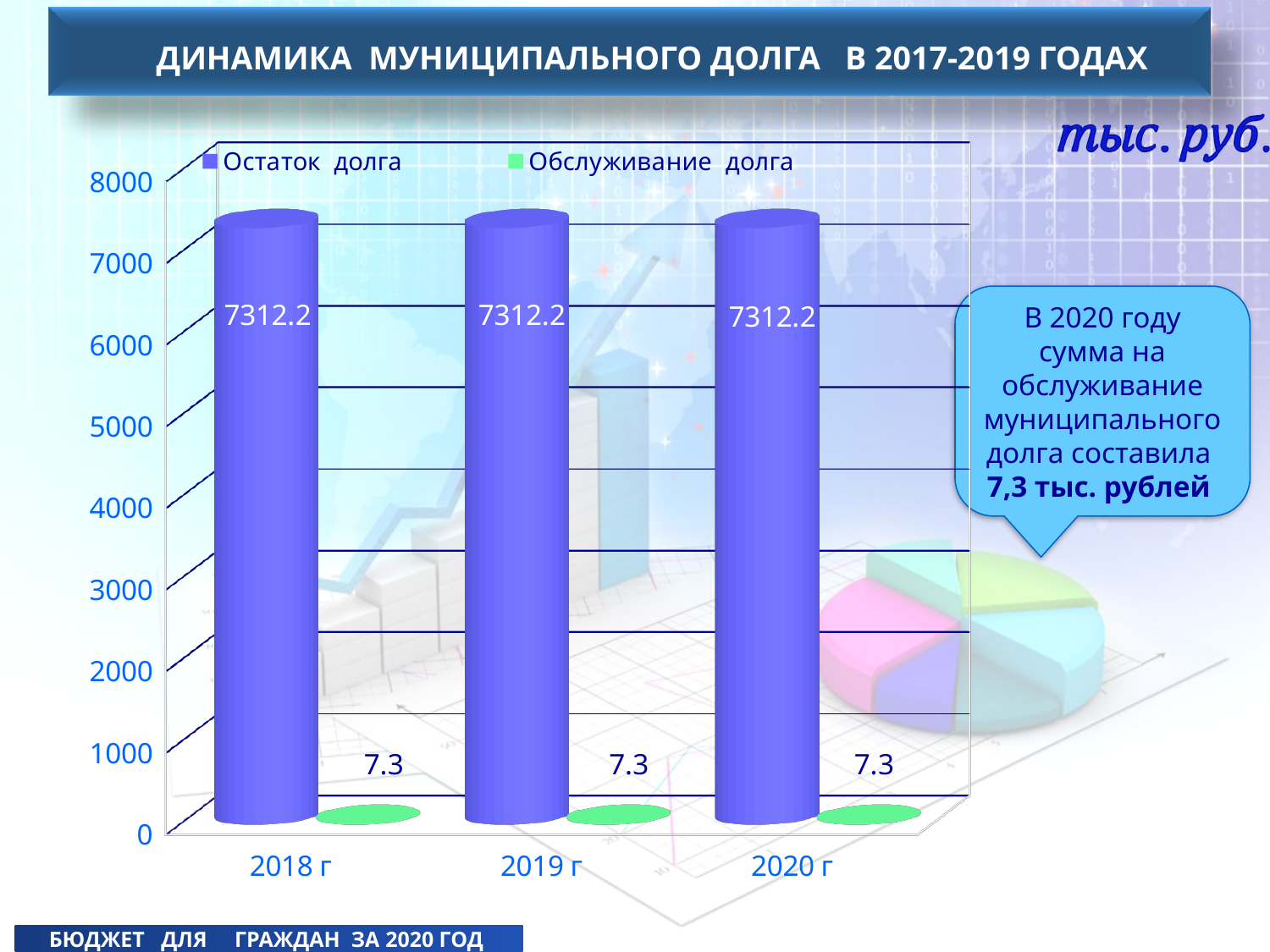
Is the value of Остаток долга for 2019 г greater or less than 7000? greater What is the value of Обслуживание долга for 2020 г? 7.3 How many series does the chart legend list? 2 Does the value of Остаток долга rise, fall or stay the same from 2018 г to 2020 г? stays the same Which series has the larger value for 2018 г, Остаток долга or Обслуживание долга? Остаток долга What is the value of Остаток долга for 2018 г? 7312.2 What is the difference between Остаток долга and Обслуживание долга for 2019 г? 7304.9 How many years are shown on the x axis of the chart? 3 What is the value of Обслуживание долга for 2019 г? 7.3 What kind of chart is shown on the slide? bar chart What unit of measurement is indicated for the chart values? тыс. руб. What is the value of Остаток долга for 2020 г? 7312.2